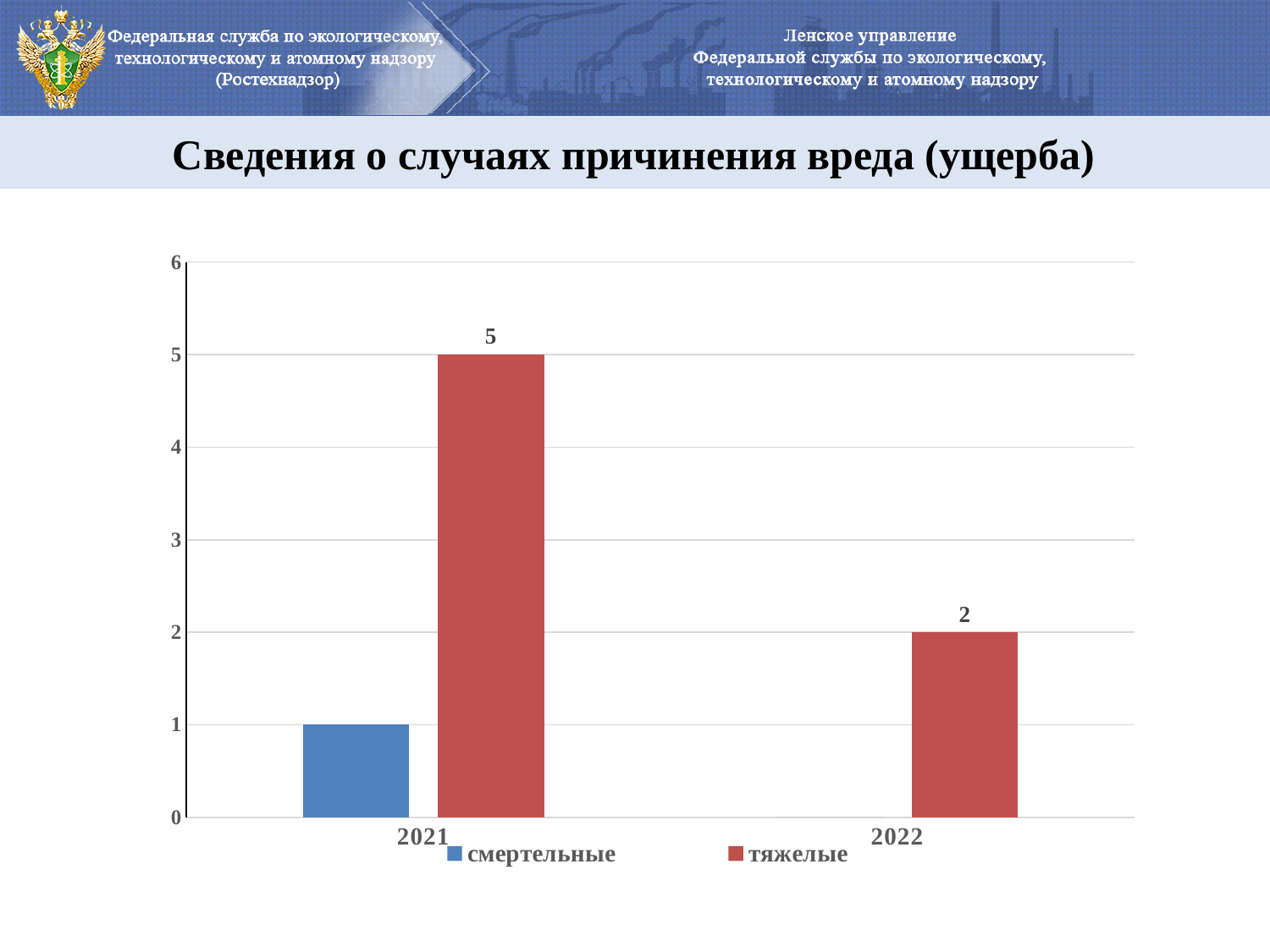
Does the value for тяжелые rise or fall from 2021 to 2022? fall Which year has the larger value for тяжелые, 2021 or 2022? 2021 What kind of chart is shown on the slide? bar chart What is the value for смертельные in 2021? 1 How many years are shown on the x axis? 2 In 2021, what is the difference between the тяжелые and смертельные values? 4 What is the title of the slide above the chart? Сведения о случаях причинения вреда (ущерба) What is the value for тяжелые in 2022? 2 What is the value for тяжелые in 2021? 5 How many series does the legend list? 2 What is the difference between the тяжелые values for 2021 and 2022? 3 Which year has the highest value for тяжелые? 2021